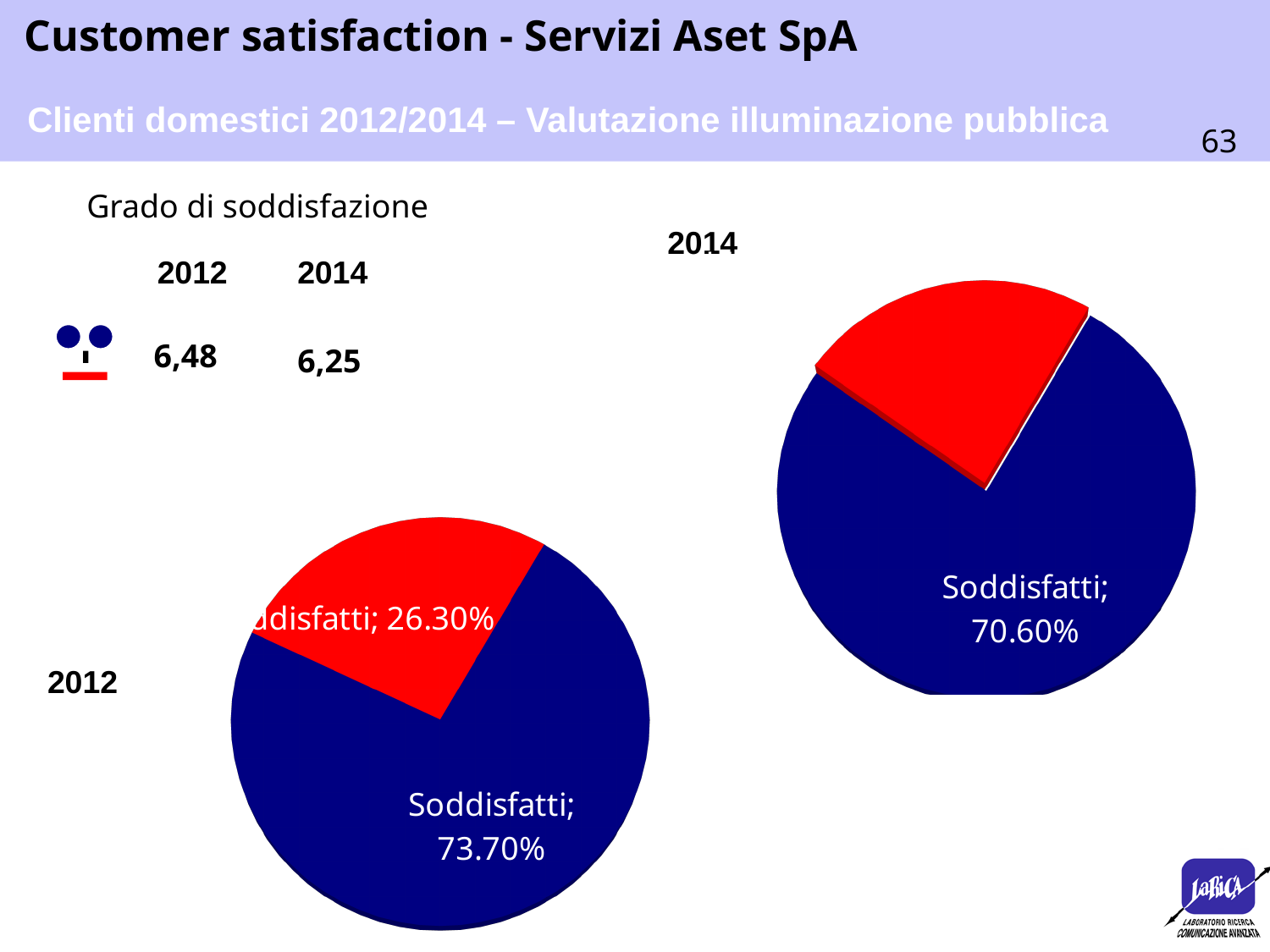
How many pie charts are shown on the slide? 2 Is the Soddisfatti share larger in the 2012 pie chart or the 2014 pie chart? 2012 Which slice is the largest in the 2014 pie chart? Soddisfatti What kind of chart is used to show the 2012 data? Pie chart In the 2012 pie chart, what is the difference between the Soddisfatti slice and the red slice? 47.40 percentage points In the 2014 pie chart, what percentage is shown for Soddisfatti? 70.60% Which slice is the smallest in the 2012 pie chart? The red slice (26.30%) In the 2012 pie chart, what percentage is printed on the red slice? 26.30% How many slices does the 2014 pie chart have? 2 What colour is the Soddisfatti slice in both pie charts? Dark blue In the 2012 pie chart, what percentage is shown for Soddisfatti? 73.70% What is the difference between the Soddisfatti share in the 2012 pie chart and in the 2014 pie chart? 3.10 percentage points